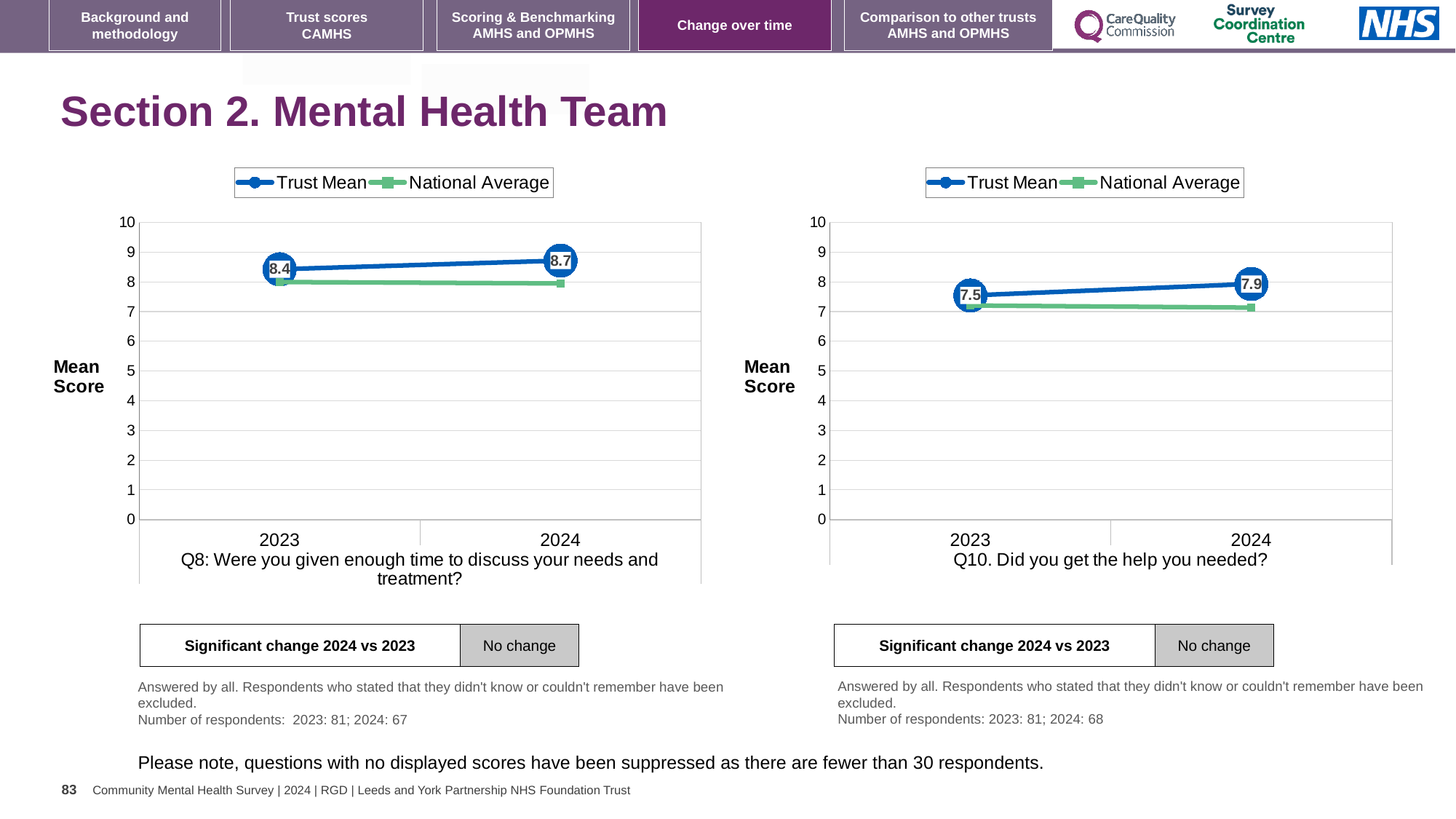
In the Q10 chart (right), does the Trust Mean rise or fall from 2023 to 2024? rise What kind of chart is the Q8 chart (left)? line chart In the Q8 chart (left), what is the Trust Mean for 2023? 8.4 In the Q10 chart (right), is the National Average for 2024 greater or less than 8? less In the Q8 chart (left), which series is higher in 2024, Trust Mean or National Average? Trust Mean In the Q8 chart (left), by how much did the Trust Mean change from 2023 to 2024? 0.3 In the Q10 chart (right), what is the difference between the Trust Mean in 2024 and in 2023? 0.4 In the Q8 chart (left), what is the Trust Mean for 2024? 8.7 How many years are shown on the x axis of the Q10 chart (right)? 2 In the Q10 chart (right), what is the Trust Mean for 2023? 7.5 In the Q10 chart (right), what is the Trust Mean for 2024? 7.9 How many series does the legend of the Q8 chart (left) list? 2